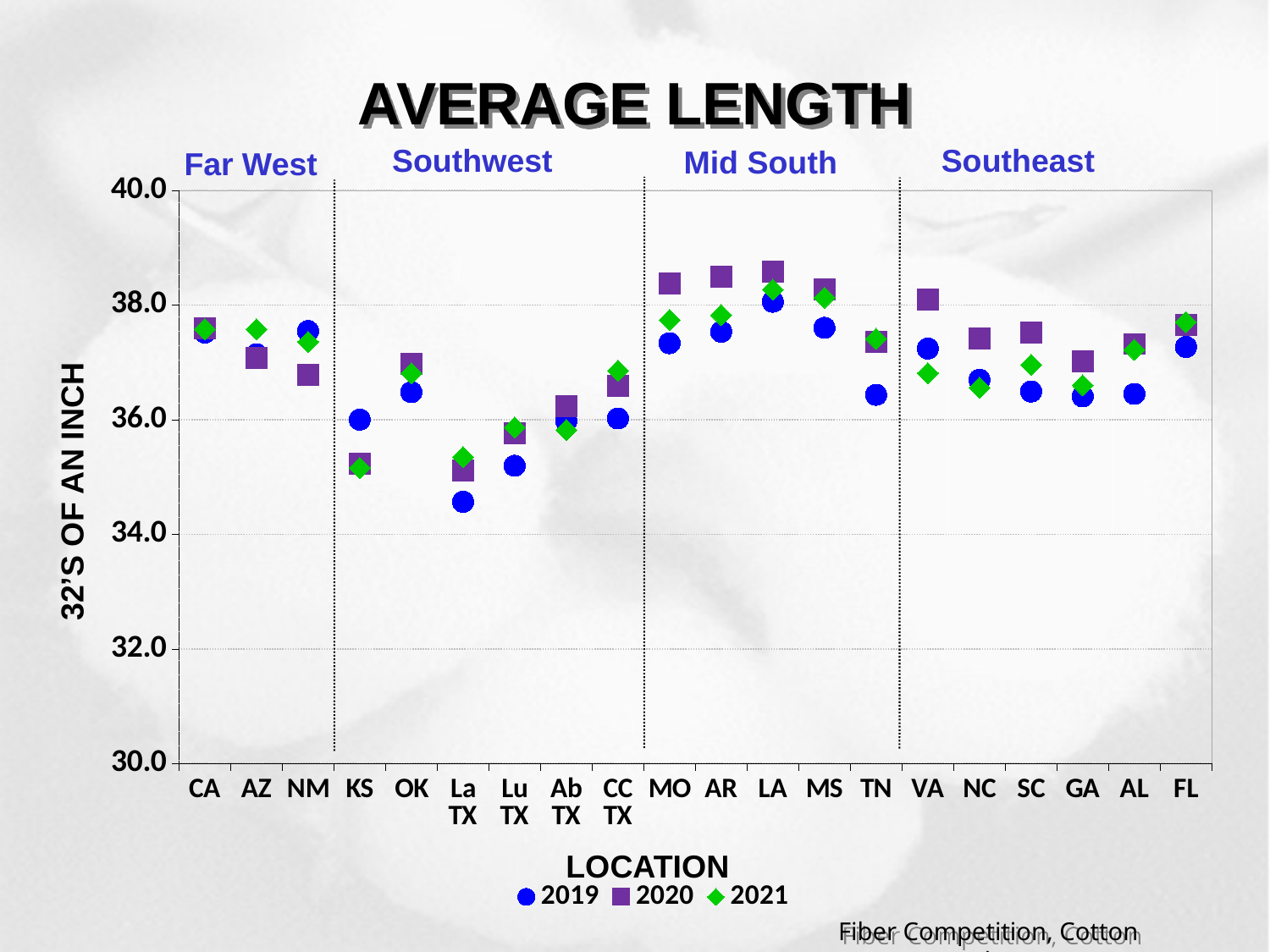
What is the label on the y axis? 32'S OF AN INCH How many series does the legend list? 3 Which location has the highest 2019 value? LA Is the 2021 value for KS greater or less than 36.0? less What kind of chart is shown on the slide? scatter chart How many locations are plotted along the x axis? 20 What is the title of the chart? AVERAGE LENGTH Is the 2019 value for La TX greater or less than 36.0? less Is the 2020 value for LA greater or less than 38.0? greater For MO, which is larger: the 2019 value or the 2020 value? 2020 Which location has the lowest 2019 value? La TX